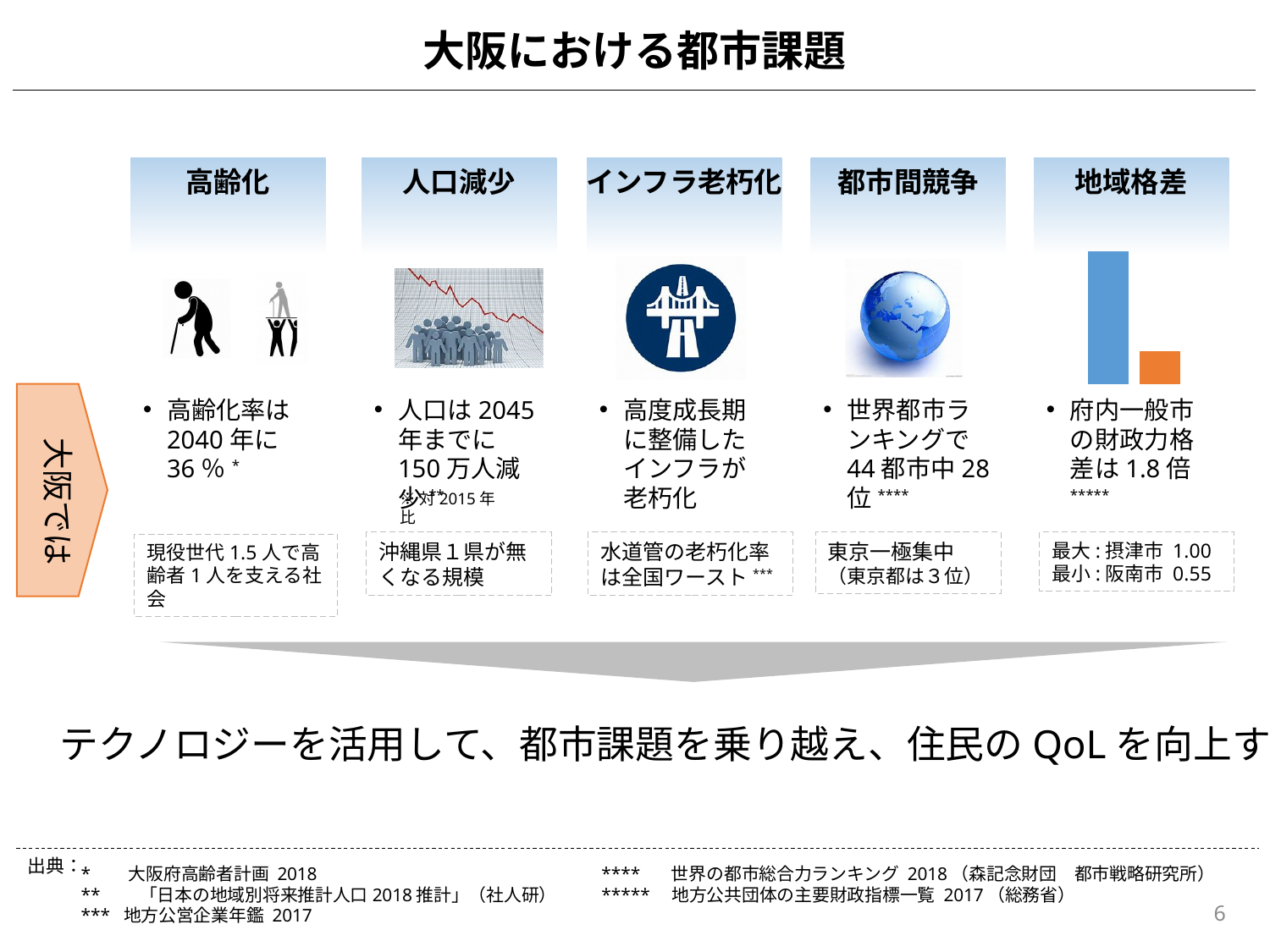
How many bars does the chart under the 地域格差 heading have? 2 In the chart under the 地域格差 heading, which bar is taller, the blue one or the orange one? the blue one Under which of the five headings on the slide does the bar chart appear? 地域格差 What kind of chart is shown under the 地域格差 heading? bar chart In the chart under the 地域格差 heading, what colour is the shorter bar? orange